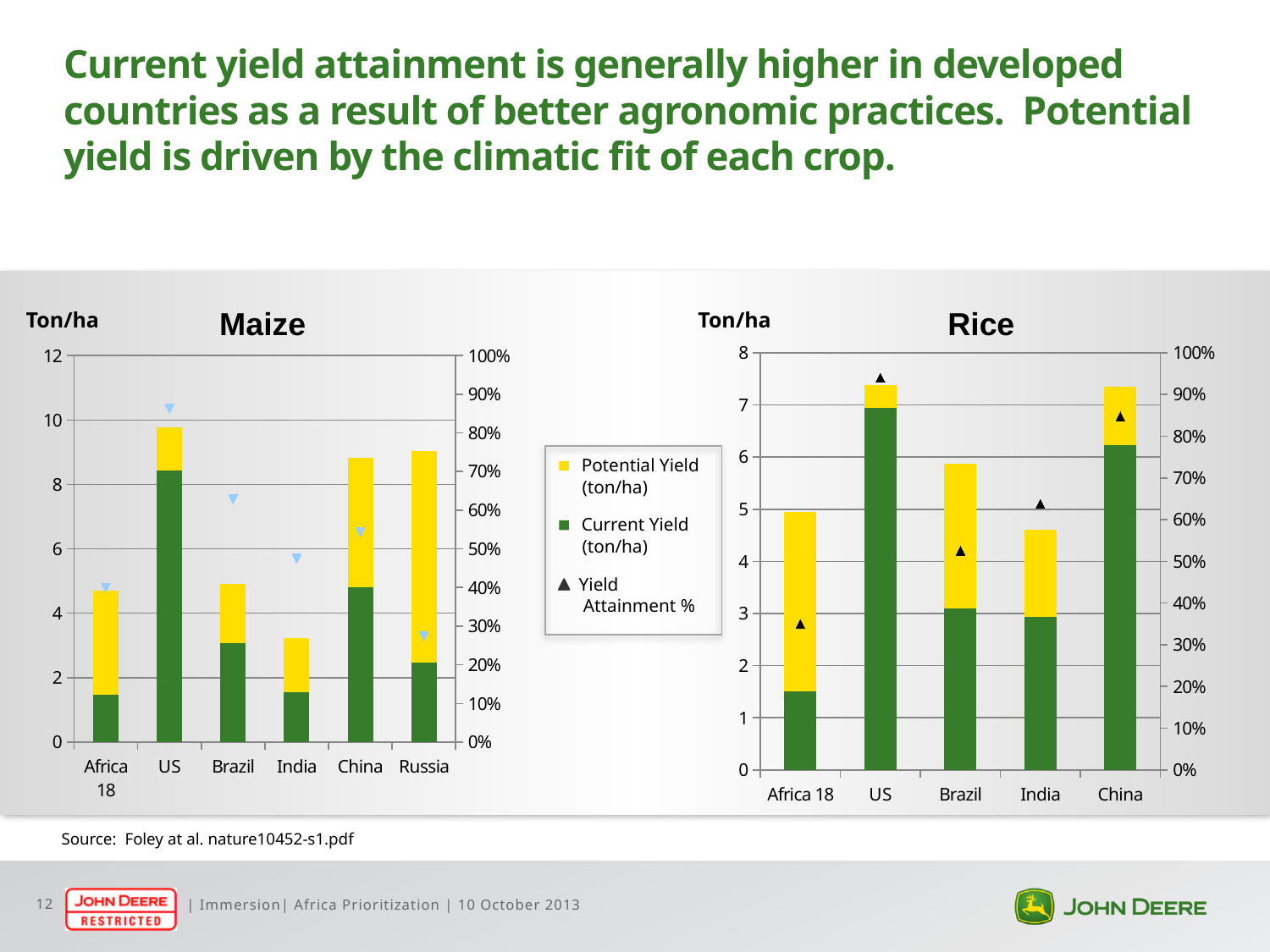
On the Rice chart, is the current yield for Africa 18 greater or less than 2 ton/ha? less On the Rice chart, which country has the lowest current yield? Africa 18 What type of chart is the Maize chart? bar chart What colour represents Current Yield (ton/ha) in the legend? green How many countries/regions are shown on the Rice chart? 5 On the Rice chart, which country has the highest yield attainment %? US On the Maize chart, which country has the lowest yield attainment %? Russia On the Maize chart, is the current yield for the US greater or less than 8 ton/ha? greater How many series does the legend list? 3 On the Maize chart, which country has the highest current yield? US How many countries/regions are shown on the Maize chart? 6 On the Rice chart, which has the larger current yield, US or Brazil? US